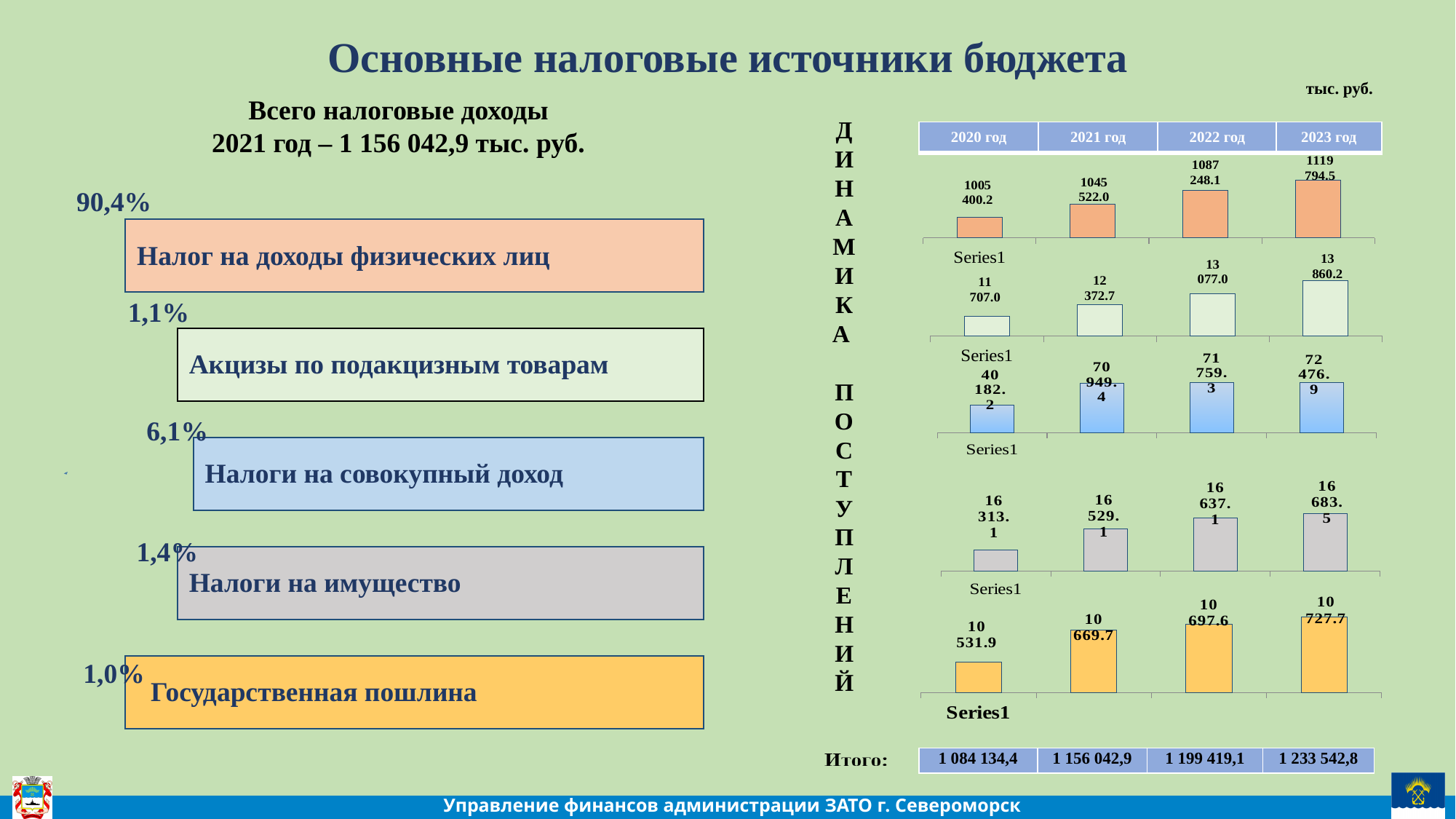
In the top (orange) chart on the right, do the values rise or fall from 2020 год to 2023 год? rise In the bottom (yellow) chart on the right, which year has the highest value? 2023 год In the top (orange) chart on the right, what is the value for 2020 год? 1005 400.2 In the third (blue) chart on the right, which is larger: the value for 2020 год or the value for 2021 год? 2021 год In the third (blue) chart on the right, which year has the lowest value? 2020 год In the fourth (grey) chart on the right, what is the difference between the 2023 год and 2020 год values? 370.4 In the second (light green) chart on the right, what is the value for 2021 год? 12 372.7 How many bars does the bottom (yellow) chart on the right have? 4 What type of chart is the fourth (grey) chart on the right? bar chart In the second (light green) chart on the right, what is the difference between the 2023 год and 2020 год values? 2 153.2 In the top (orange) chart on the right, what is the value for 2023 год? 1119 794.5